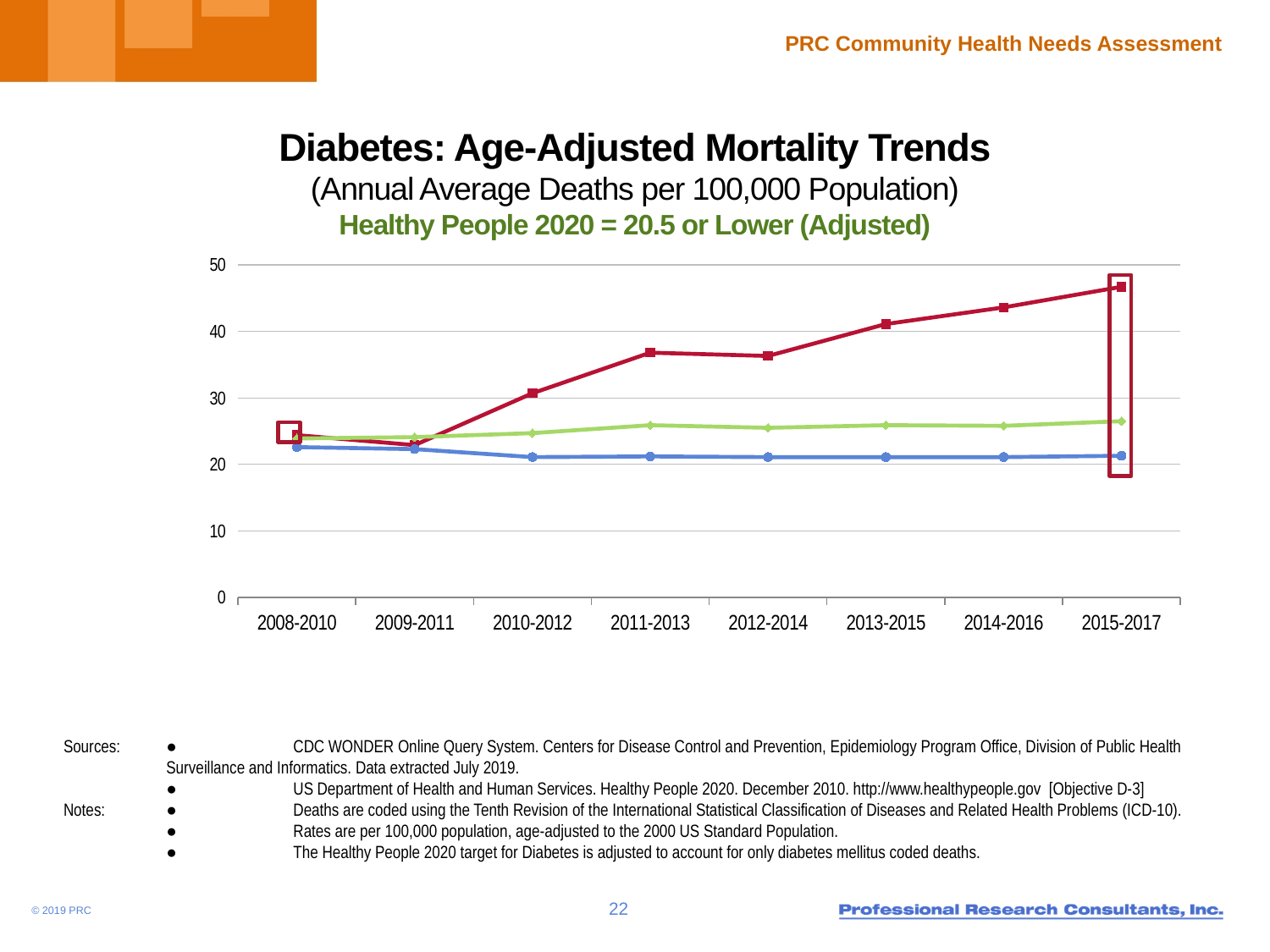
What kind of chart is shown on the slide? line chart How many lines are plotted on the chart? 3 Is the value of the green line for 2015-2017 greater or less than 20? greater Is the value of the blue line for 2015-2017 greater or less than 30? less What is the title of the chart? Diabetes: Age-Adjusted Mortality Trends Does the red line rise or fall from 2008-2010 to 2015-2017? rises Is the value of the red line for 2011-2013 greater or less than 30? greater In 2015-2017, which line has the larger value, the red line or the blue line? the red line What Healthy People 2020 target is stated above the chart? 20.5 or Lower (Adjusted) How many time periods are shown on the x axis of the chart? 8